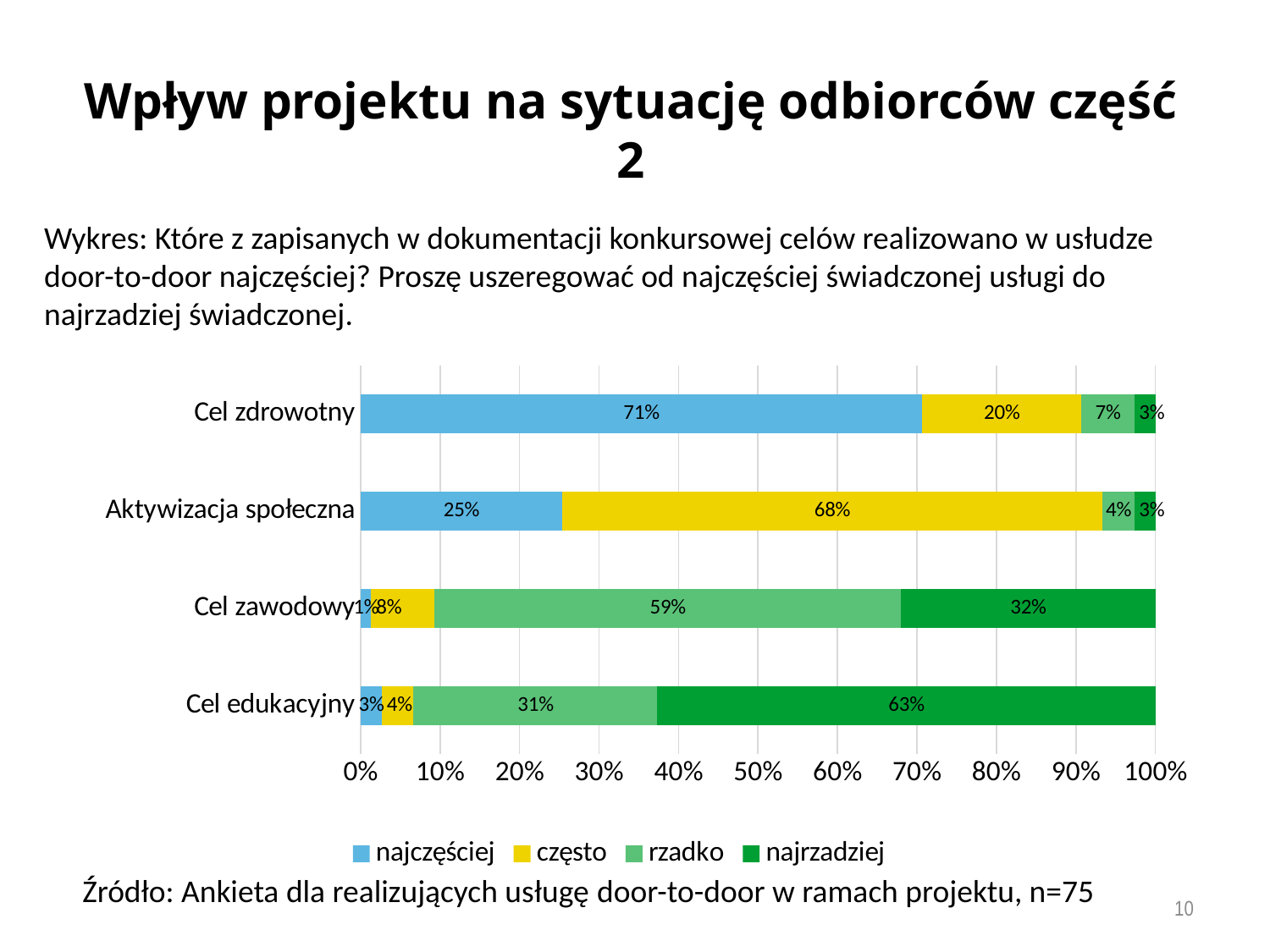
Which series is shown in yellow in the legend? często Which category has the highest 'najczęściej' value? Cel zdrowotny How many categories are shown on the chart? 4 Which is larger: the 'często' value for Cel zdrowotny or the 'często' value for Cel zawodowy? Cel zdrowotny What is the difference between the 'najrzadziej' values for Cel edukacyjny and Cel zawodowy? 31% What is the 'rzadko' value for Cel zawodowy? 59% What kind of chart is shown on the slide? stacked bar chart What is the 'często' value for Aktywizacja społeczna? 68% How many series does the legend list? 4 What is the 'najrzadziej' value for Cel edukacyjny? 63% What is the 'najczęściej' value for Cel zdrowotny? 71%